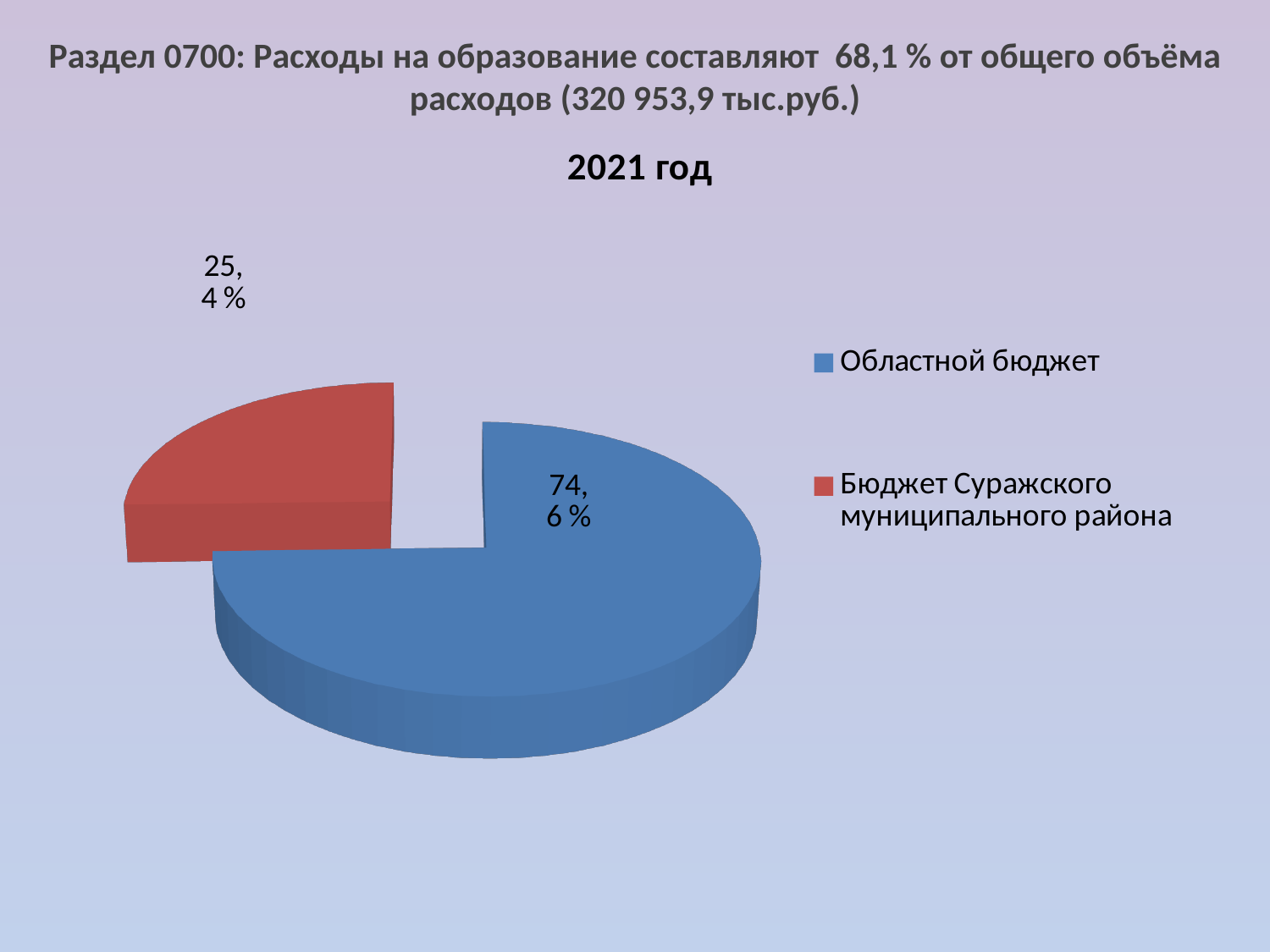
What is the difference in percentage points between the Областной бюджет share and the Бюджет Суражского муниципального района share? 49,2 % What share of the pie does Бюджет Суражского муниципального района have? 25,4 % Which slice of the pie is the largest? Областной бюджет What colour is the slice for Бюджет Суражского муниципального района? red Which slice of the pie is the smallest? Бюджет Суражского муниципального района How many slices does the pie chart have? 2 Which is larger: the share for Областной бюджет or the share for Бюджет Суражского муниципального района? Областной бюджет How many entries does the legend list? 2 What is the title of the chart? 2021 год What kind of chart is shown on the slide? pie chart What share of the pie does Областной бюджет have? 74,6 %